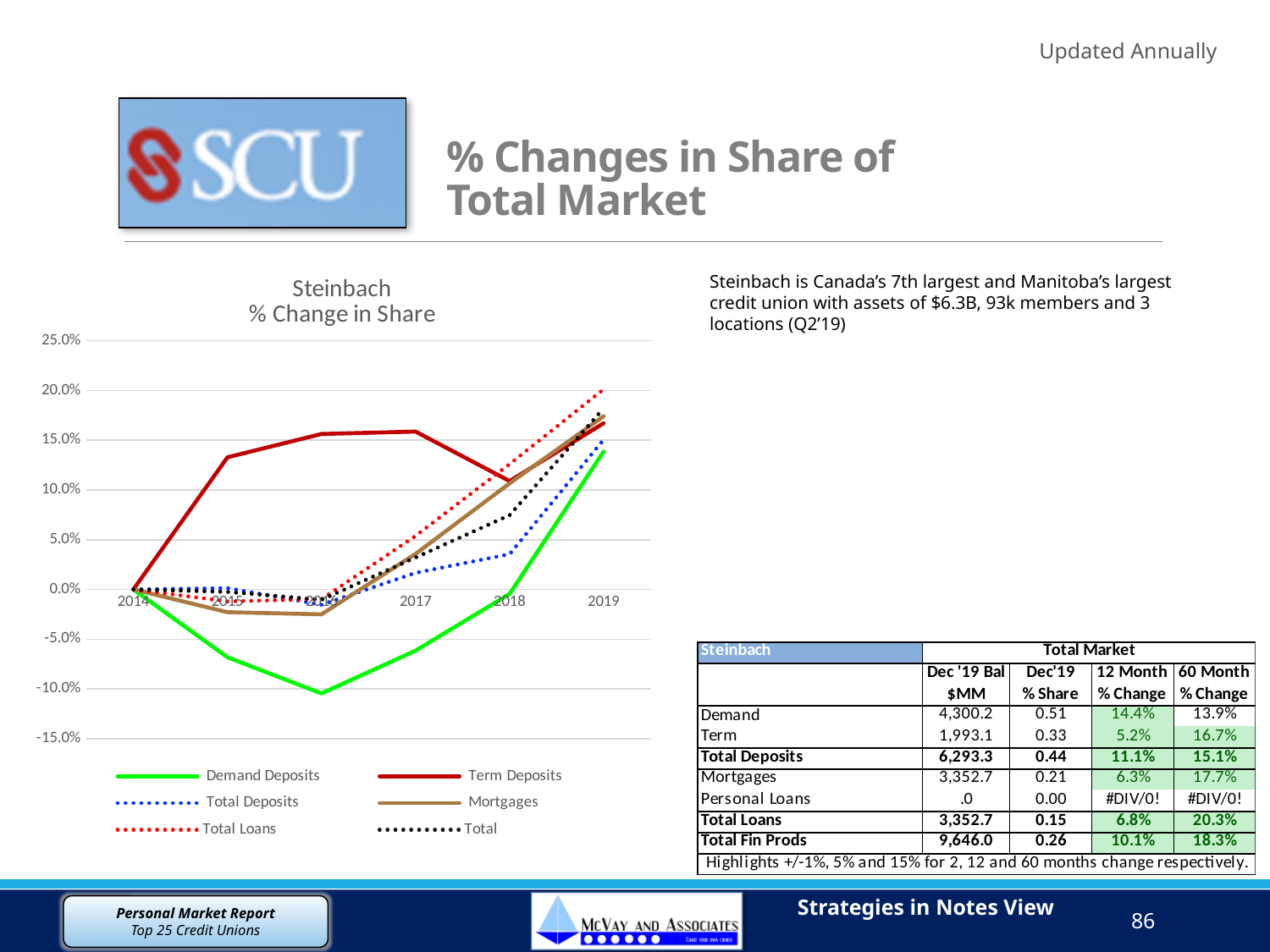
Which series is drawn as a solid green line? Demand Deposits Which series has the highest value in 2019? Total Loans Does the Demand Deposits line rise or fall from 2016 to 2019? rise How many series does the chart legend list? 6 In 2015, which is larger: Term Deposits or Demand Deposits? Term Deposits What kind of chart is shown on the slide? line chart Is the value for Demand Deposits in 2016 greater or less than -5.0%? less Is the value for Term Deposits in 2017 greater or less than 10.0%? greater What is the title of the chart? Steinbach % Change in Share Which series has the lowest value in 2016? Demand Deposits Which series has the highest value in 2017? Term Deposits How many years are plotted along the x axis of the chart? 6